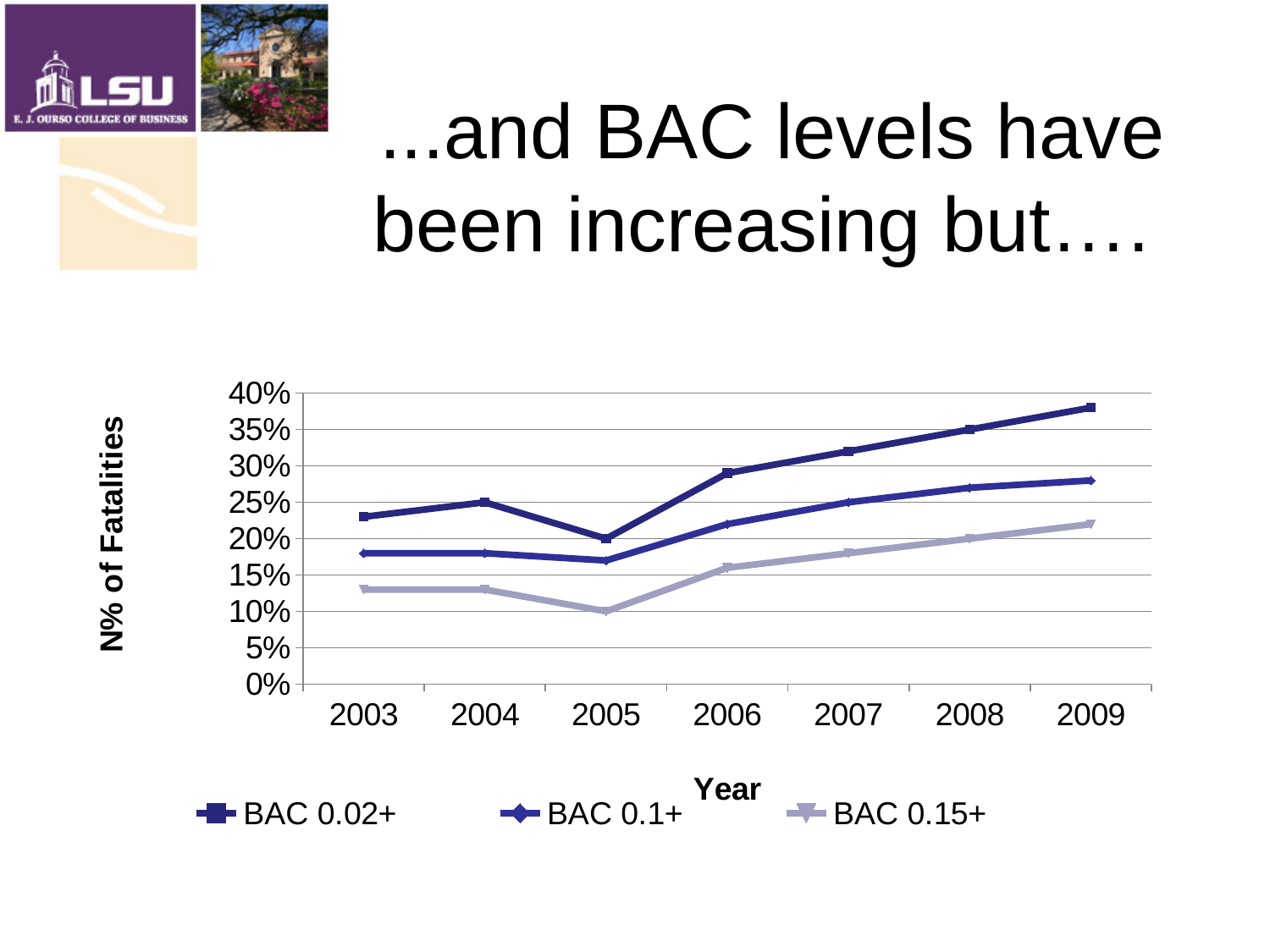
From 2006 to 2009, do the values for BAC 0.1+ rise or fall? Rise Is the value for BAC 0.15+ in 2005 greater or less than 15%? less What kind of chart is shown on the slide? Line chart How many series does the legend list? 3 Is the value for BAC 0.02+ in 2009 greater or less than 35%? greater Which year has the highest value for the BAC 0.02+ series? 2009 How many years are plotted along the x axis? 7 Is the value for BAC 0.1+ in 2003 greater or less than 20%? less Which year has the lowest value for the BAC 0.02+ series? 2005 Which year has the lowest value for the BAC 0.15+ series? 2005 In 2007, which series has the larger value, BAC 0.02+ or BAC 0.15+? BAC 0.02+ What is the label on the x axis of the chart? Year